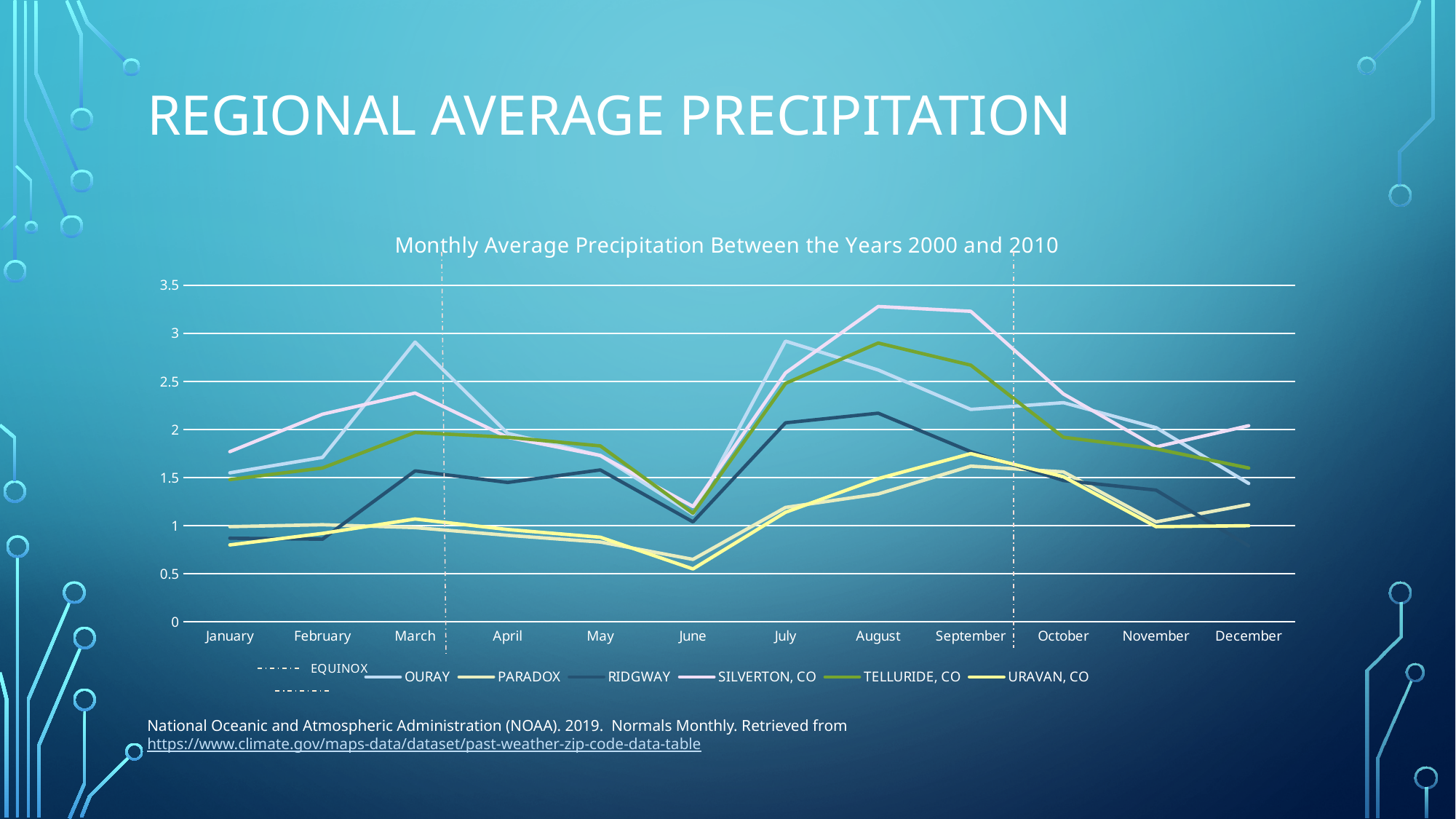
Is the value for TELLURIDE, CO in August greater or less than 2.5? greater Is the value for SILVERTON, CO in August greater or less than 3? greater Is the value for OURAY in March greater or less than 2.5? greater How many entries does the chart's legend list? 7 Which series has the highest value in March? OURAY Which series has the highest value in August? SILVERTON, CO Does the SILVERTON, CO line rise or fall from June to August? Rise In March, which is larger: the value for OURAY or the value for TELLURIDE, CO? OURAY How many months are shown along the x axis of the chart? 12 What is the title of the chart? Monthly Average Precipitation Between the Years 2000 and 2010 What kind of chart is shown on the slide? Line chart